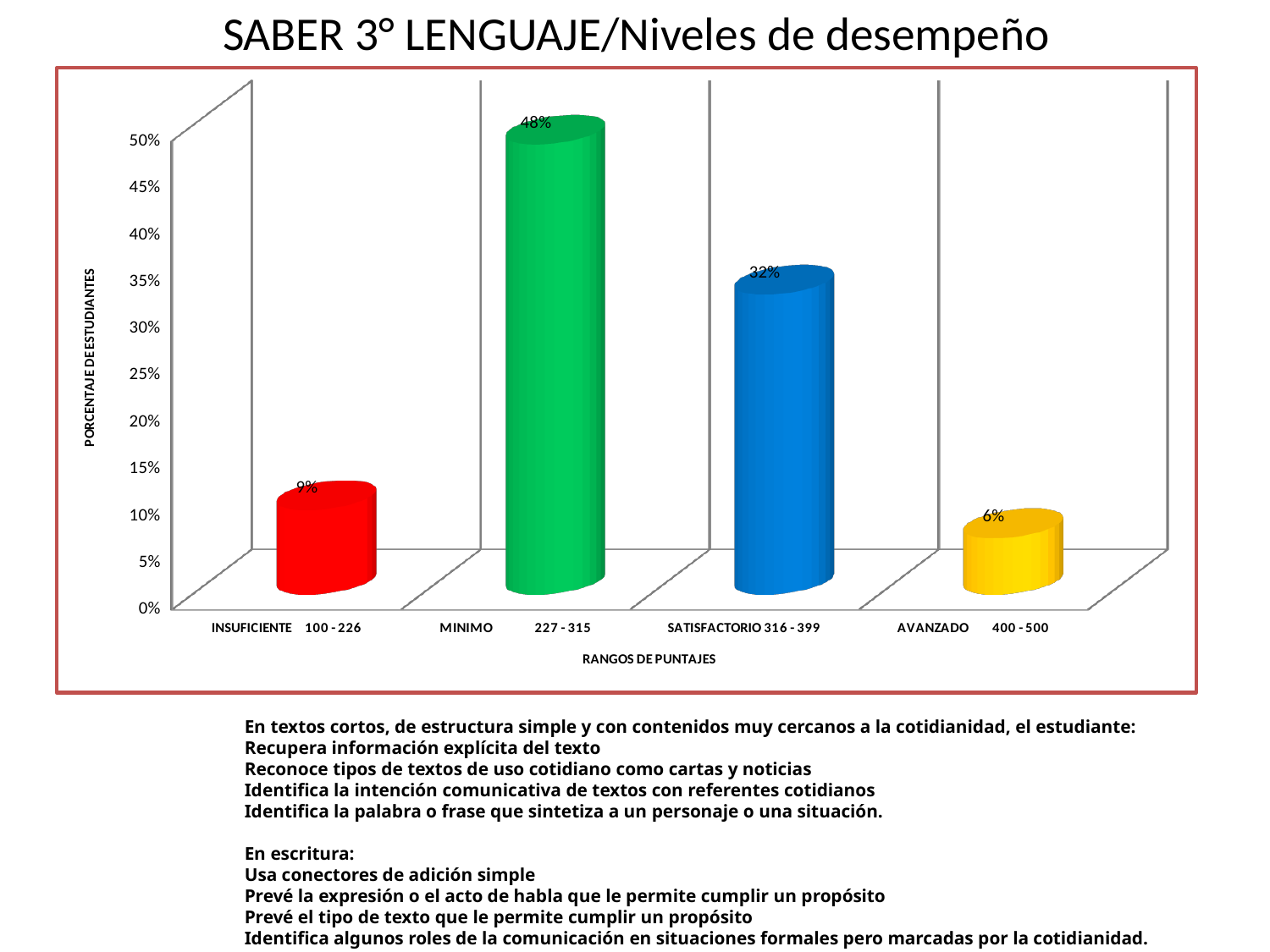
What percentage of students is shown for the INSUFICIENTE 100 - 226 level? 9% What is the label of the vertical axis? PORCENTAJE DE ESTUDIANTES What percentage of students is shown for the AVANZADO 400 - 500 level? 6% What percentage of students is shown for the SATISFACTORIO 316 - 399 level? 32% What is the difference in percentage points between the MINIMO and SATISFACTORIO levels? 16% What kind of chart is shown on the slide? Bar chart How many performance levels (categories) are shown on the x axis? 4 Which performance level has the highest percentage of students? MINIMO 227 - 315 Which performance level has the lowest percentage of students? AVANZADO 400 - 500 Which has a larger percentage of students, INSUFICIENTE or AVANZADO? INSUFICIENTE What is the title of the chart? SABER 3° LENGUAJE/Niveles de desempeño What percentage of students is shown for the MINIMO 227 - 315 level? 48%